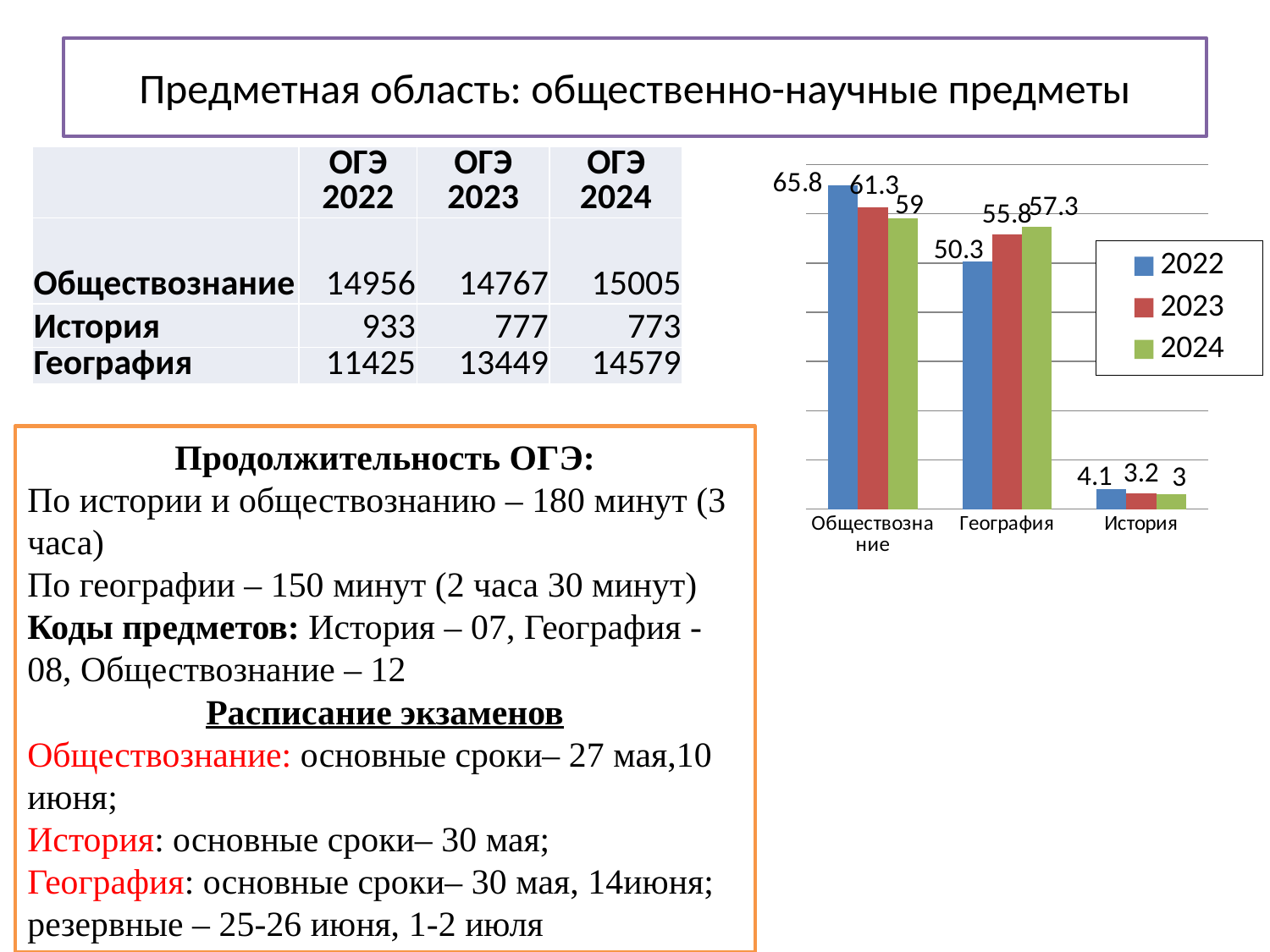
Which category has the highest value in the 2022 series? Обществознание Do the values for Обществознание rise or fall from 2022 to 2024? fall How many categories are shown on the x axis of the chart? 3 Which category has the lowest value in the 2024 series? История What is the difference between the 2024 and 2022 values for География? 7 How many series does the chart legend list? 3 What is the value for География in the 2024 series? 57.3 What kind of chart is shown on the slide? bar chart Which is larger for География: the 2023 value or the 2022 value? 2023 What is the value for История in the 2023 series? 3.2 What is the difference between the 2022 and 2024 values for Обществознание? 6.8 What is the value for Обществознание in the 2022 series? 65.8